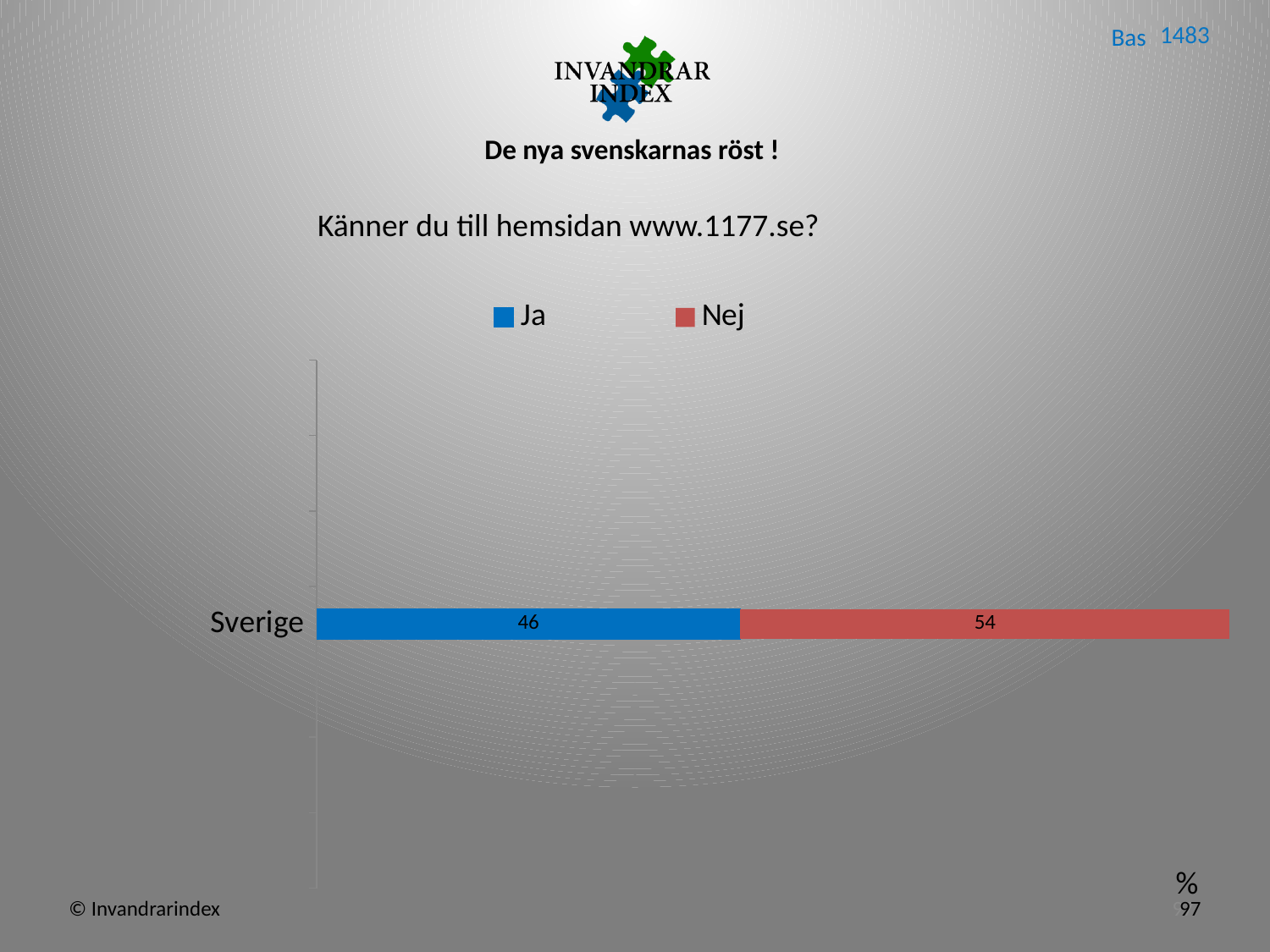
What is the total of the stacked bar for Sverige? 100 What is the value for Ja for Sverige? 46 How many series does the legend list? 2 Which category is shown on the chart's axis? Sverige Is the Ja value for Sverige greater or less than 50? less What is the value for Nej for Sverige? 54 What kind of chart is shown on the slide? Stacked bar chart Which colour represents Nej in the legend? Red What is the difference between the Nej and Ja values for Sverige? 8 Which series has the larger value for Sverige, Ja or Nej? Nej How many categories are plotted on the chart? 1